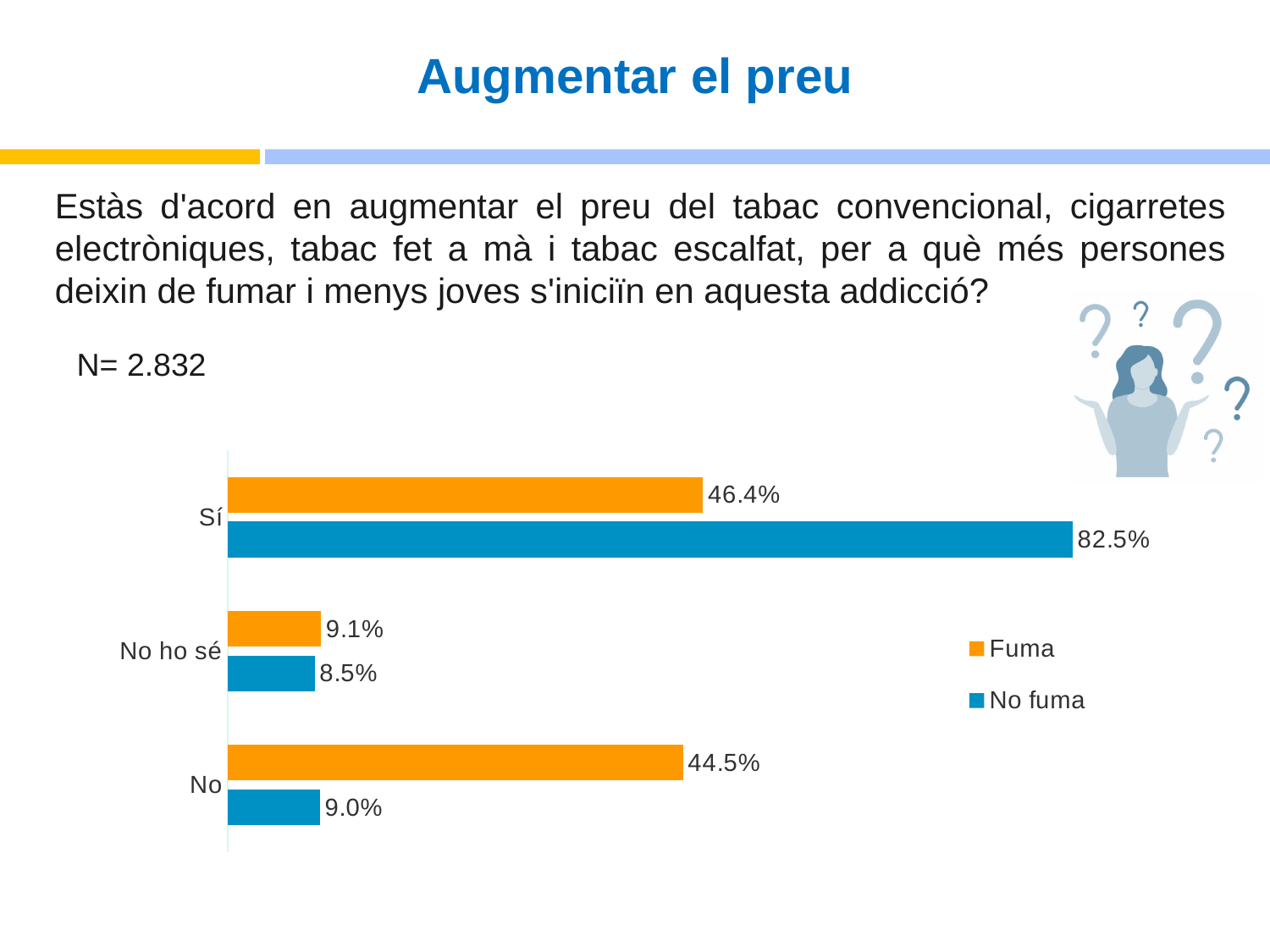
How many categories are shown on the chart? 3 What is the value for "Fuma" in the "Sí" category? 46.4% Which category has the highest value for the "No fuma" series? Sí What is the value for "No fuma" in the "No ho sé" category? 8.5% Which colour represents the "No fuma" series? Blue What is the value for "No fuma" in the "Sí" category? 82.5% What is the difference between the "No fuma" and "Fuma" values in the "Sí" category? 36.1% What is the value for "Fuma" in the "No" category? 44.5% What kind of chart is shown on the slide? Bar chart Which category has the lowest value for the "Fuma" series? No ho sé How many series does the legend list? 2 Which is larger in the "No" category: the "Fuma" value or the "No fuma" value? Fuma